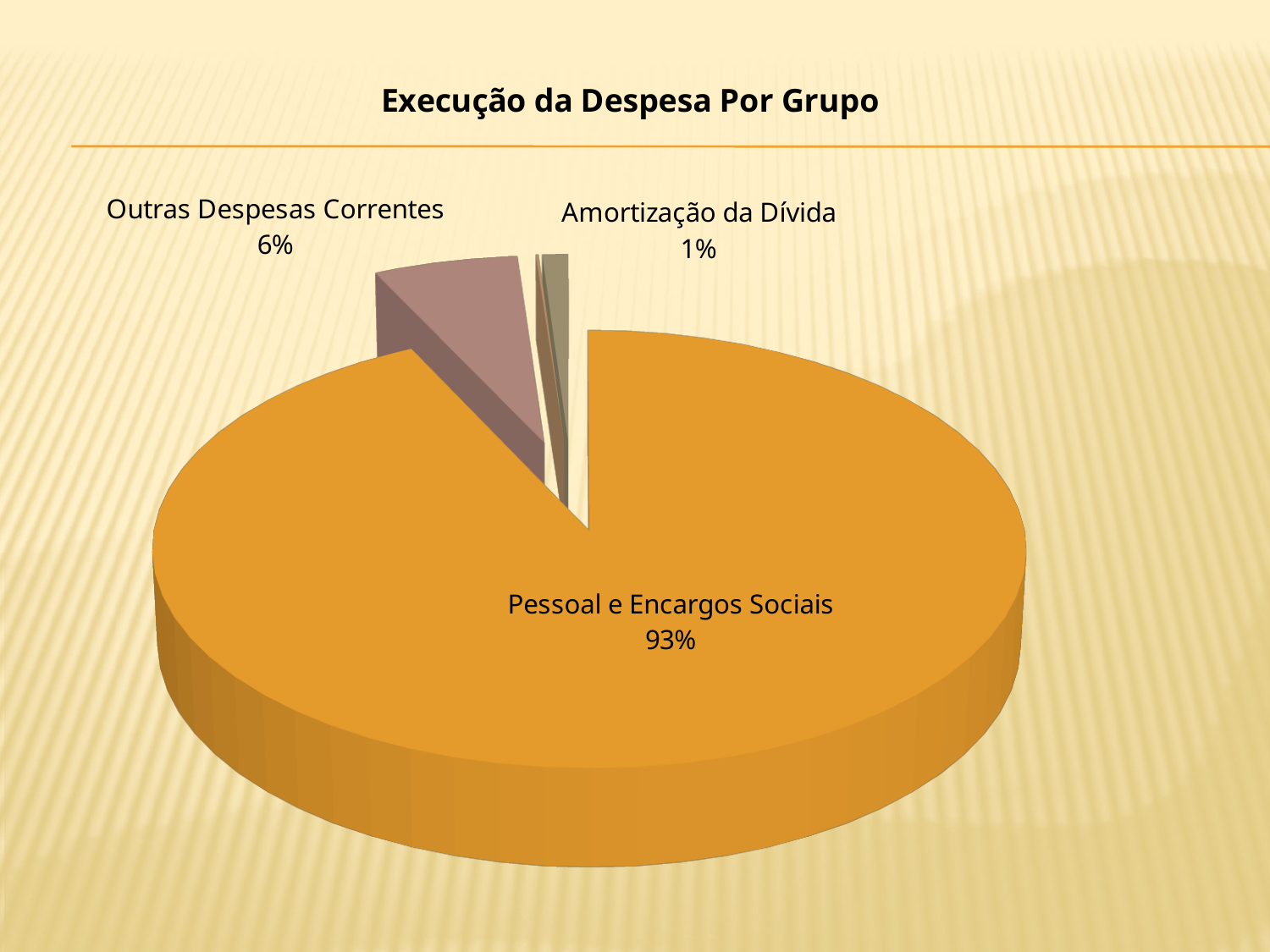
Which is larger: Outras Despesas Correntes or Amortização da Dívida? Outras Despesas Correntes Which group has the largest share of the pie? Pessoal e Encargos Sociais What is the difference in percentage points between Pessoal e Encargos Sociais and Outras Despesas Correntes? 87 What type of chart is shown on the slide? pie chart What percentage of the pie is Amortização da Dívida? 1% What colour is the Pessoal e Encargos Sociais slice? orange What is the title of the pie chart? Execução da Despesa Por Grupo What is the difference in percentage points between Outras Despesas Correntes and Amortização da Dívida? 5 What percentage of the pie is Outras Despesas Correntes? 6% Which labelled group has the smallest share of the pie? Amortização da Dívida What percentage of the pie is Pessoal e Encargos Sociais? 93% What is the combined share of Outras Despesas Correntes and Amortização da Dívida? 7%